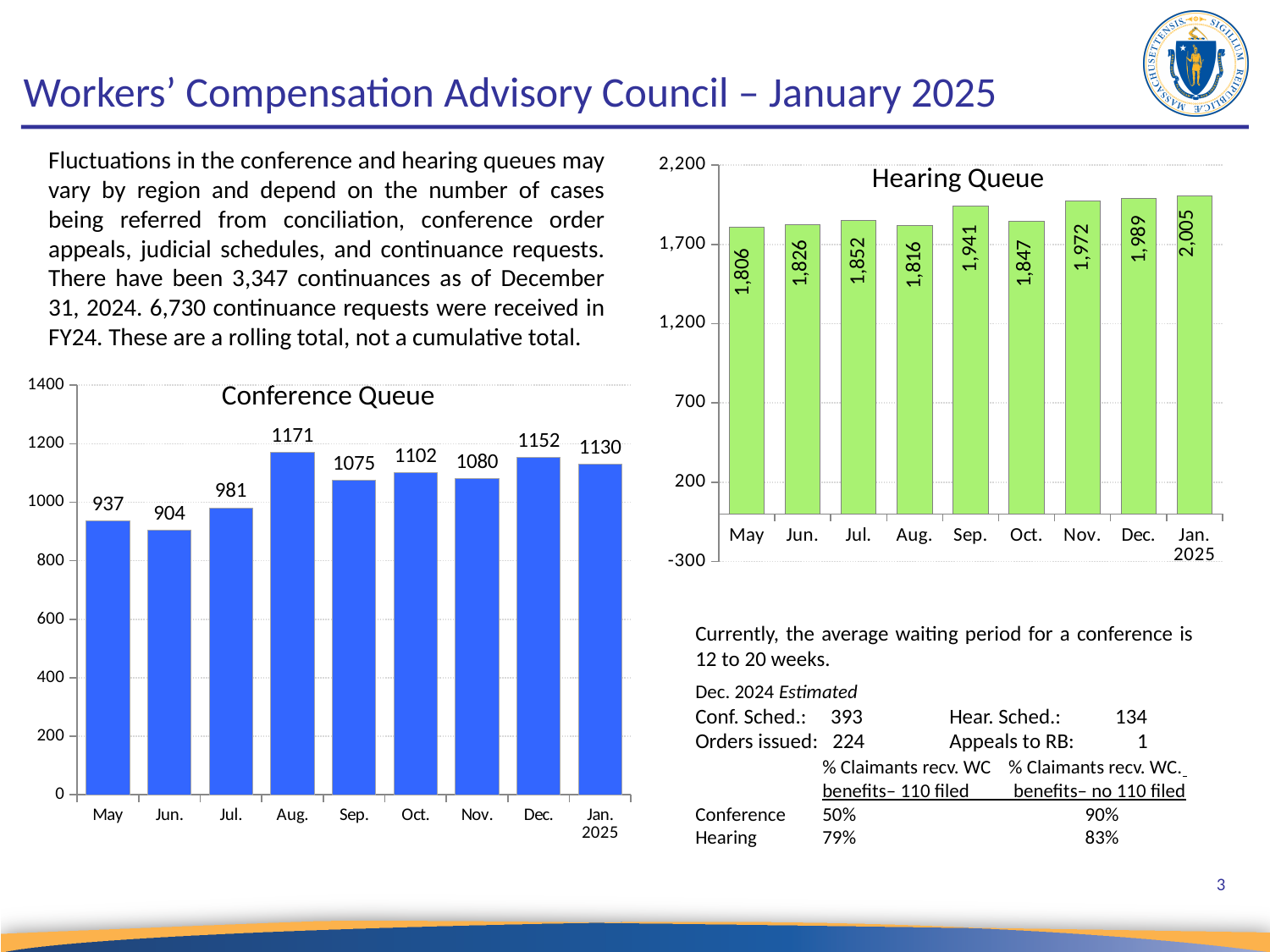
In the Conference Queue chart, what is the difference between the values for Dec. and Jan. 2025? 22 What kind of chart is the Hearing Queue chart? bar chart What colour are the bars in the Conference Queue chart? blue In the Hearing Queue chart, which month has the highest value? Jan. 2025 In the Conference Queue chart, which is larger, the value for Sep. or the value for Oct.? Oct. In the Hearing Queue chart, what is the value for Jan. 2025? 2,005 In the Conference Queue chart, which month has the lowest value? Jun. How many months are shown in the Conference Queue chart? 9 In the Hearing Queue chart, do the values rise or fall from Oct. to Jan. 2025? rise In the Hearing Queue chart, is the value for May greater or less than 1,700? greater In the Conference Queue chart, what is the value for Aug.? 1171 In the Hearing Queue chart, what is the difference between the values for Sep. and Oct.? 94